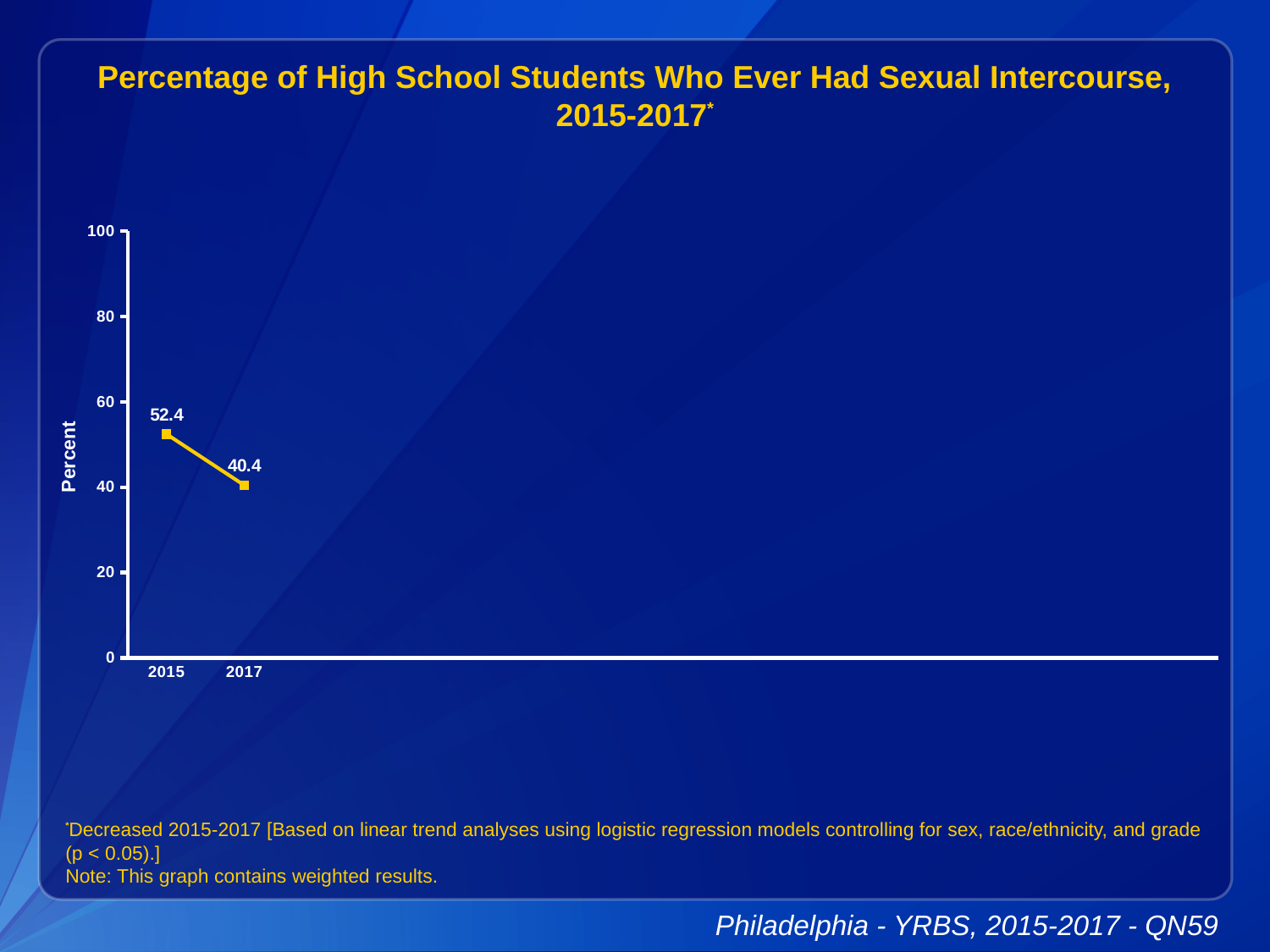
What is the value for 2017? 40.4 What is the label on the vertical axis? Percent What is the difference between the values for 2015 and 2017? 12.0 Which is larger, the value for 2015 or the value for 2017? 2015 Which year has the lowest value? 2017 What is the value for 2015? 52.4 Is the value for 2017 greater or less than 60? less Is the value for 2015 greater or less than 40? greater Which year has the highest value? 2015 What kind of chart is shown on the slide? line chart How many years are plotted on the chart? 2 Do the values rise or fall from 2015 to 2017? fall